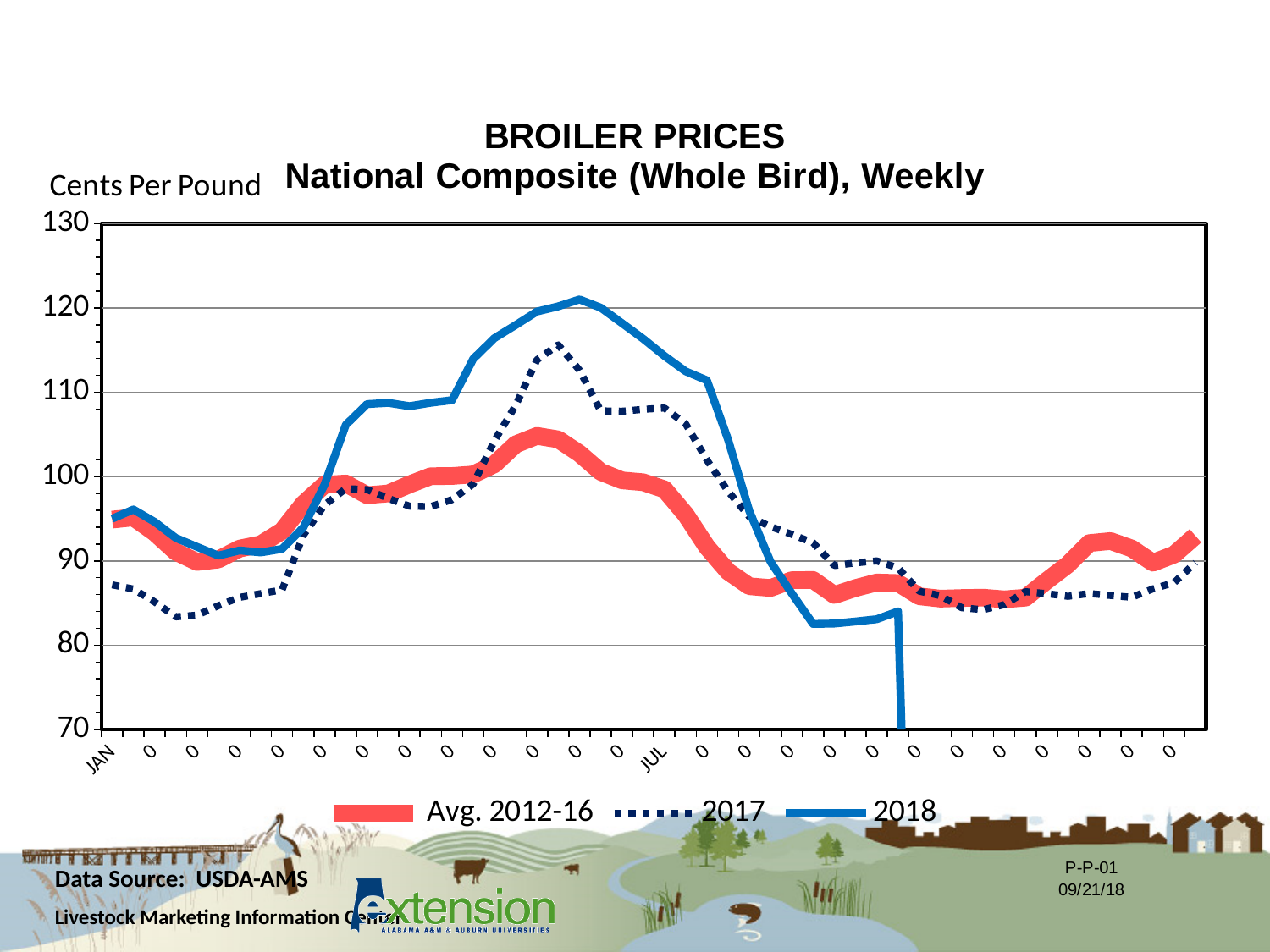
Which series reaches the highest peak on the chart? 2018 At JAN, which is higher, the Avg. 2012-16 line or the 2017 line? Avg. 2012-16 What kind of chart is shown on the slide? line chart Which series has the lowest value at JAN? 2017 How many series does the legend list? 3 Is the value of the 2017 line at JAN greater or less than 90? less What are the three series listed in the legend? Avg. 2012-16, 2017, 2018 Is the peak value of the Avg. 2012-16 line greater or less than 110? less Is the peak value of the 2018 line greater or less than 110? greater What unit is shown on the y axis of the chart? Cents Per Pound Does the 2018 line rise or fall after JUL? fall At JUL, which is higher, the 2018 line or the 2017 line? 2018